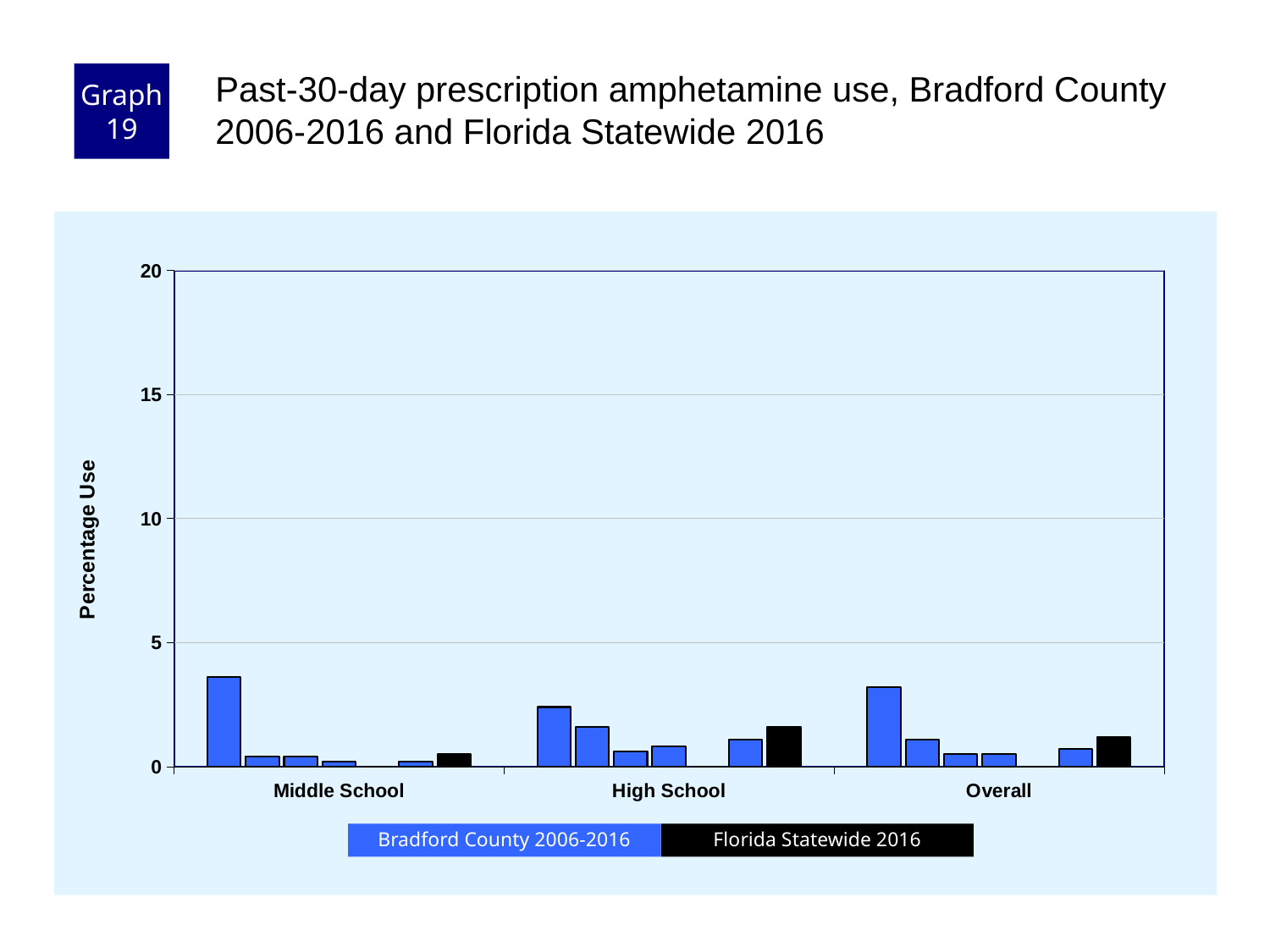
How many school-level categories are shown on the x axis? 3 Is the Florida Statewide 2016 value larger for High School or for Middle School? High School Is the tallest Bradford County bar in the Middle School group greater or less than 5? less Which category has the highest Florida Statewide 2016 value? High School Is the Florida Statewide 2016 value for High School greater or less than 5? less Which category has the lowest Florida Statewide 2016 value? Middle School What is the label of the y axis? Percentage Use What kind of chart is shown on the slide? bar chart Is the Florida Statewide 2016 value for Overall greater or less than 10? less How many series does the legend list? 2 Is the Florida Statewide 2016 value larger for Overall or for Middle School? Overall Which colour represents Florida Statewide 2016 in the legend? black